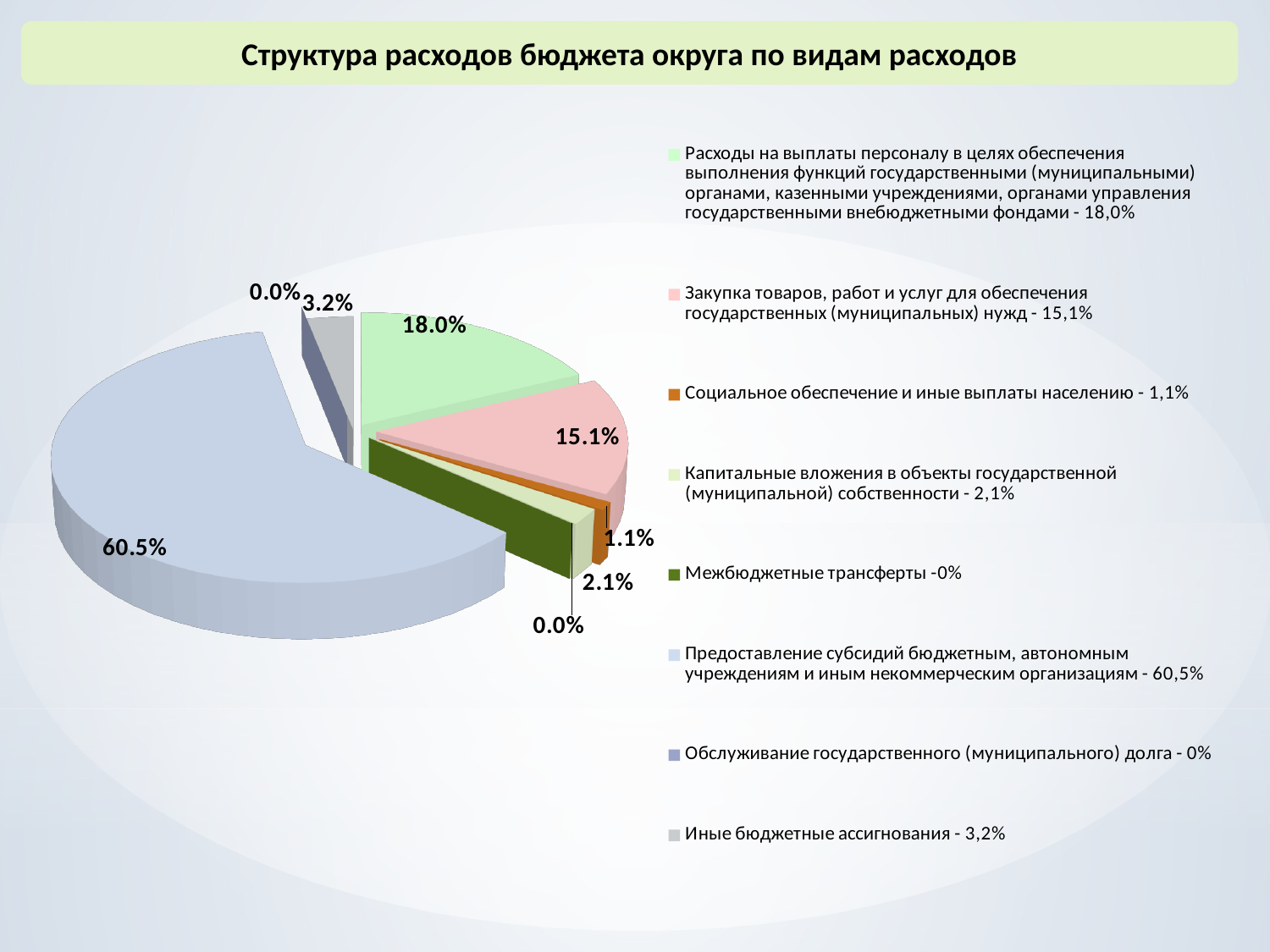
What is the difference between the slice for "Расходы на выплаты персоналу..." (18.0%) and the slice for "Закупка товаров, работ и услуг..." (15.1%)? 2.9% What kind of chart is shown on the slide? pie chart Which category has the largest slice of the pie? Предоставление субсидий бюджетным, автономным учреждениям и иным некоммерческим организациям What share of the pie is labelled for "Социальное обеспечение и иные выплаты населению"? 1.1% What is the combined share of the two slices labelled 18.0% and 60.5%? 78.5% Which is larger: the slice for "Иные бюджетные ассигнования" or the slice for "Капитальные вложения в объекты государственной (муниципальной) собственности"? Иные бюджетные ассигнования What is the title of the chart on the slide? Структура расходов бюджета округа по видам расходов How many entries does the legend list? 8 What share of the pie is labelled for "Иные бюджетные ассигнования"? 3.2% What share of the pie is labelled for "Закупка товаров, работ и услуг для обеспечения государственных (муниципальных) нужд"? 15.1% What share of the pie is labelled for "Капитальные вложения в объекты государственной (муниципальной) собственности"? 2.1% What share of the pie is labelled for "Предоставление субсидий бюджетным, автономным учреждениям и иным некоммерческим организациям"? 60.5%